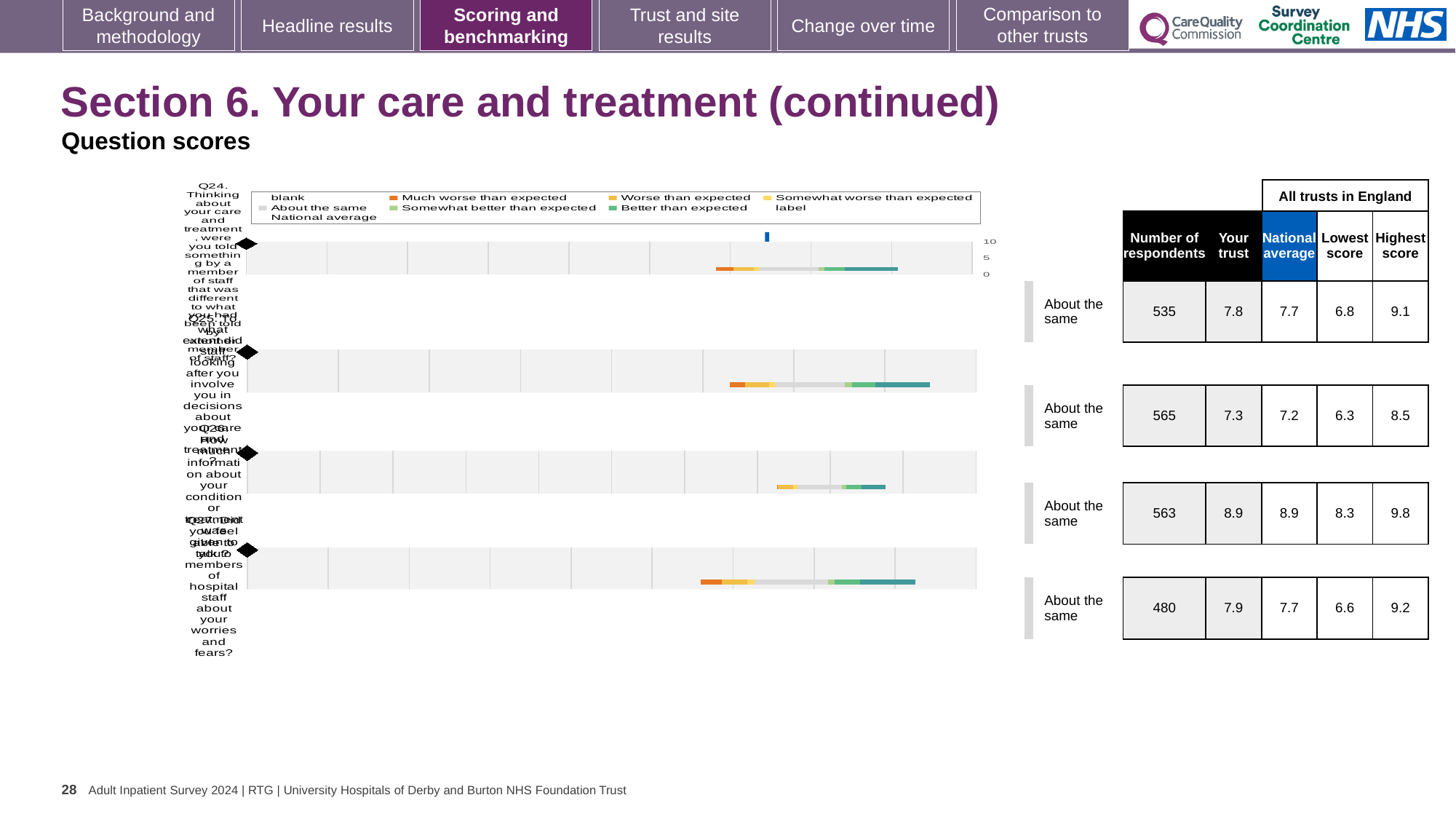
Which has more respondents, Q25 or Q26? Q25 Which question has the highest 'Your trust' score? Q26 What is the difference between the 'Your trust' score and the national average for Q24? 0.1 What is the 'Your trust' score shown for the first question (Q24)? 7.8 What is the highest score among all trusts in England for the third question (Q26)? 9.8 How many question charts (Q24 to Q27) are shown on the slide? 4 What colour is used in the legend for 'Much worse than expected'? orange Which question has the lowest 'Your trust' score? Q25 How many respondents are shown for the fourth question (Q27)? 480 What type of chart is used to show the benchmarking results for each question on this slide? bar chart What is the national average shown for the second question (Q25)? 7.2 What benchmark category is shown next to each of the four question charts? About the same